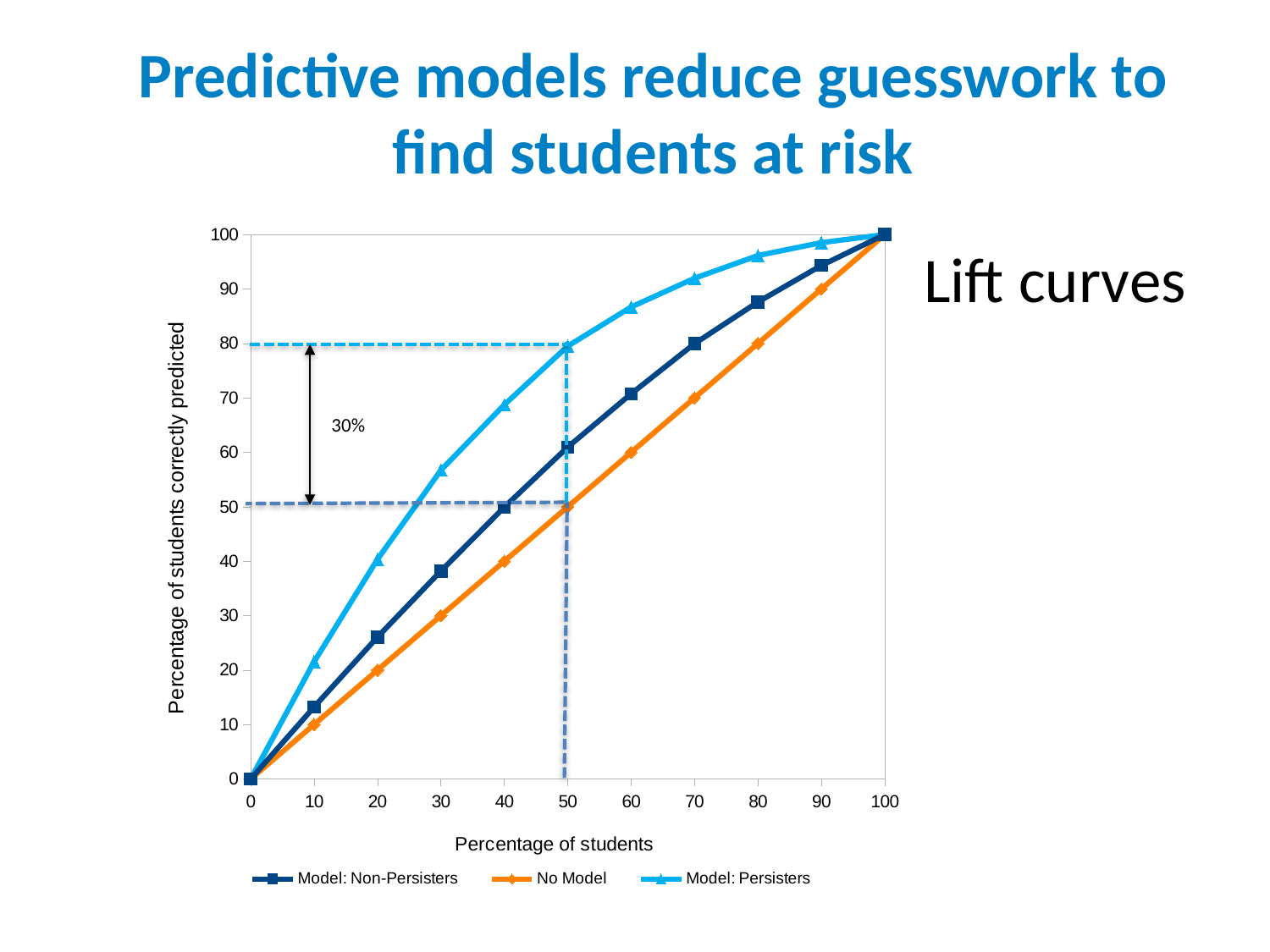
How many data points does each line have along the x axis? 11 What is the value of the No Model line at 70 on the x axis? 70 At 40 on the x axis, which is larger: Model: Persisters or Model: Non-Persisters? Model: Persisters Is the value for Model: Persisters at 60 on the x axis greater or less than 80? greater How many series does the legend list? 3 Which series has the lowest value at 40 on the x axis? No Model What kind of chart is shown on the slide? line chart Is the value for Model: Non-Persisters at 30 on the x axis greater or less than 40? less What percentage difference is annotated between the two horizontal dashed lines at 50 on the x axis? 30% What is the value of the No Model line at 50 on the x axis? 50 What is the label of the y axis? Percentage of students correctly predicted Which series has the highest value at 50 on the x axis? Model: Persisters